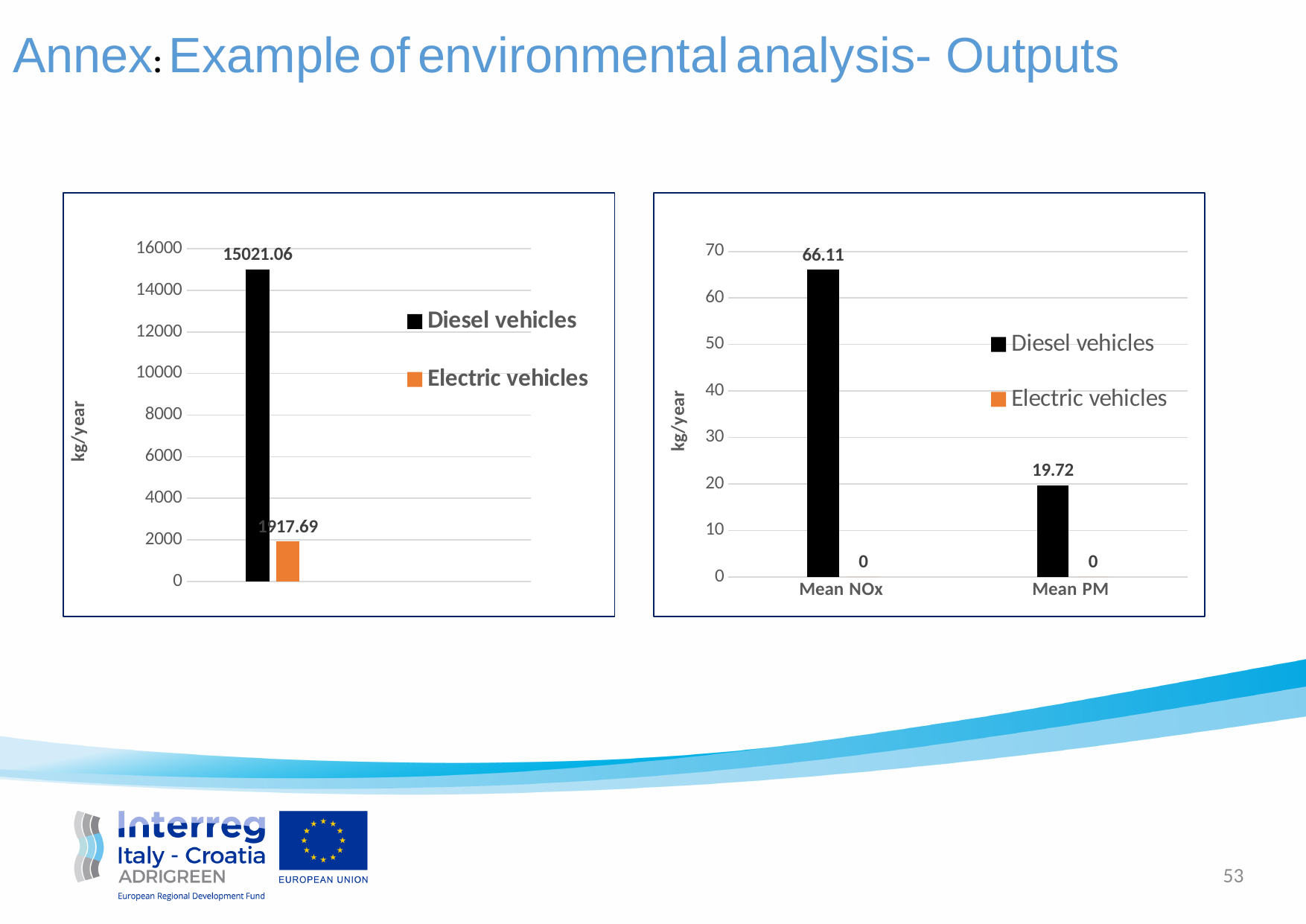
In the left chart, how many series does the legend list? 2 In the left chart, what is the value for Diesel vehicles? 15021.06 In the right chart, what is the Diesel vehicles value for Mean PM? 19.72 What kind of chart is the right chart? Bar chart In the right chart, how many categories are shown on the x axis? 2 In the left chart, which series has the larger value, Diesel vehicles or Electric vehicles? Diesel vehicles In the right chart, what is the Electric vehicles value for Mean NOx? 0 What is the y-axis label of the right chart? kg/year In the right chart, what is the difference between the Diesel vehicles values for Mean NOx and Mean PM? 46.39 In the left chart, what is the value for Electric vehicles? 1917.69 In the left chart, what is the difference between the Diesel vehicles value and the Electric vehicles value? 13103.37 In the right chart, what is the Diesel vehicles value for Mean NOx? 66.11